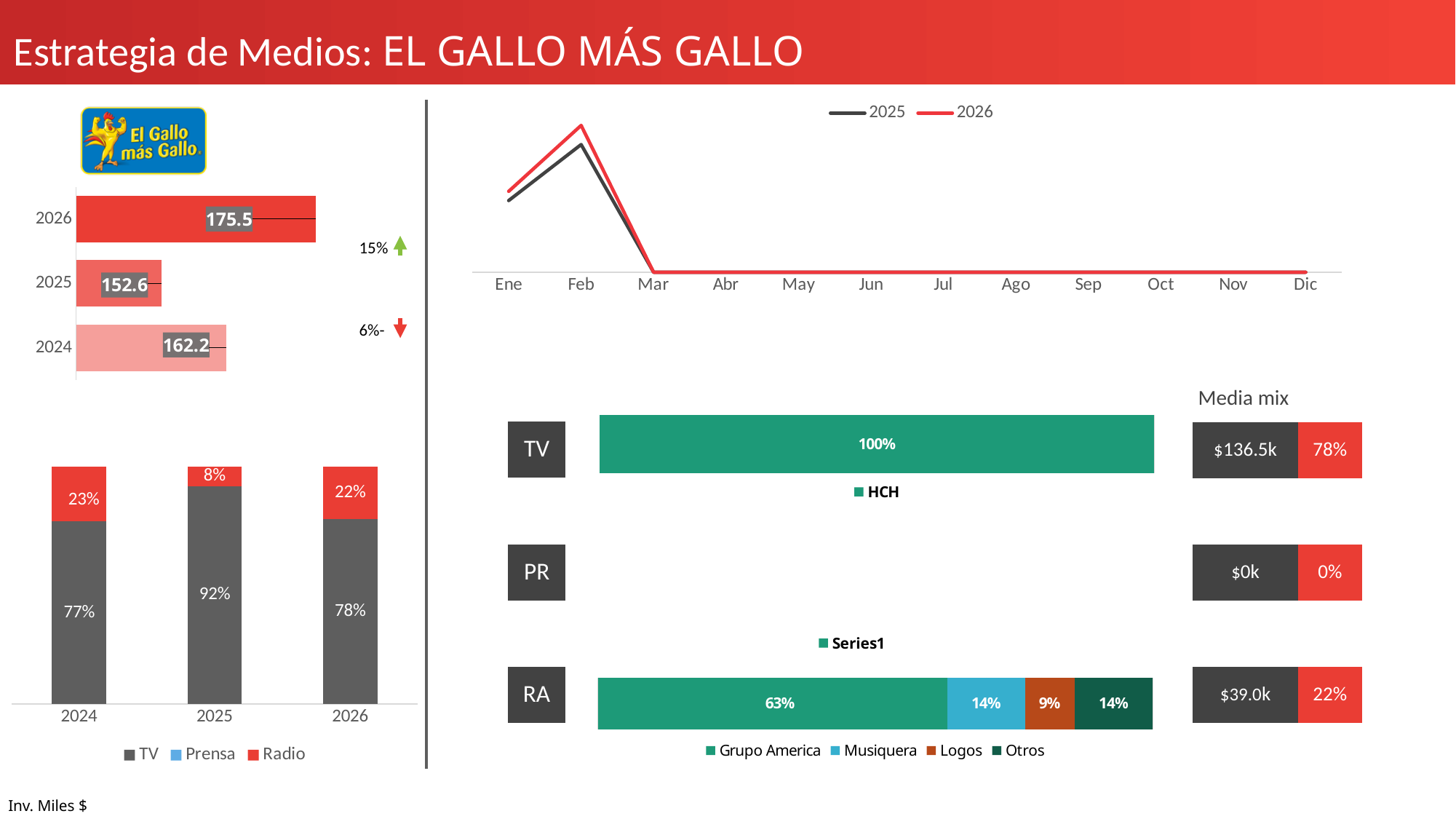
In the bottom-left stacked bar chart, what is the TV share for 2025? 92% What kind of chart is the top-right chart comparing 2025 and 2026 by month? line chart In the top-left horizontal bar chart of yearly investment, what is the value for 2025? 152.6 In the top-left horizontal bar chart of yearly investment, which year has the highest value? 2026 How many series does the legend of the bottom-left stacked bar chart list? 3 In the top-left horizontal bar chart of yearly investment, which year has the lowest value? 2025 In the bottom-left stacked bar chart, what is the Radio share for 2024? 23% In the top-left horizontal bar chart of yearly investment, what is the value for 2026? 175.5 In the RA (radio) stacked bar, what is the share for Grupo America? 63% In the top-right line chart, how many months are shown on the x axis? 12 In the Media mix table, what is the investment amount for TV? $136.5k In the top-left horizontal bar chart of yearly investment, what is the difference between the 2026 and 2025 values? 22.9